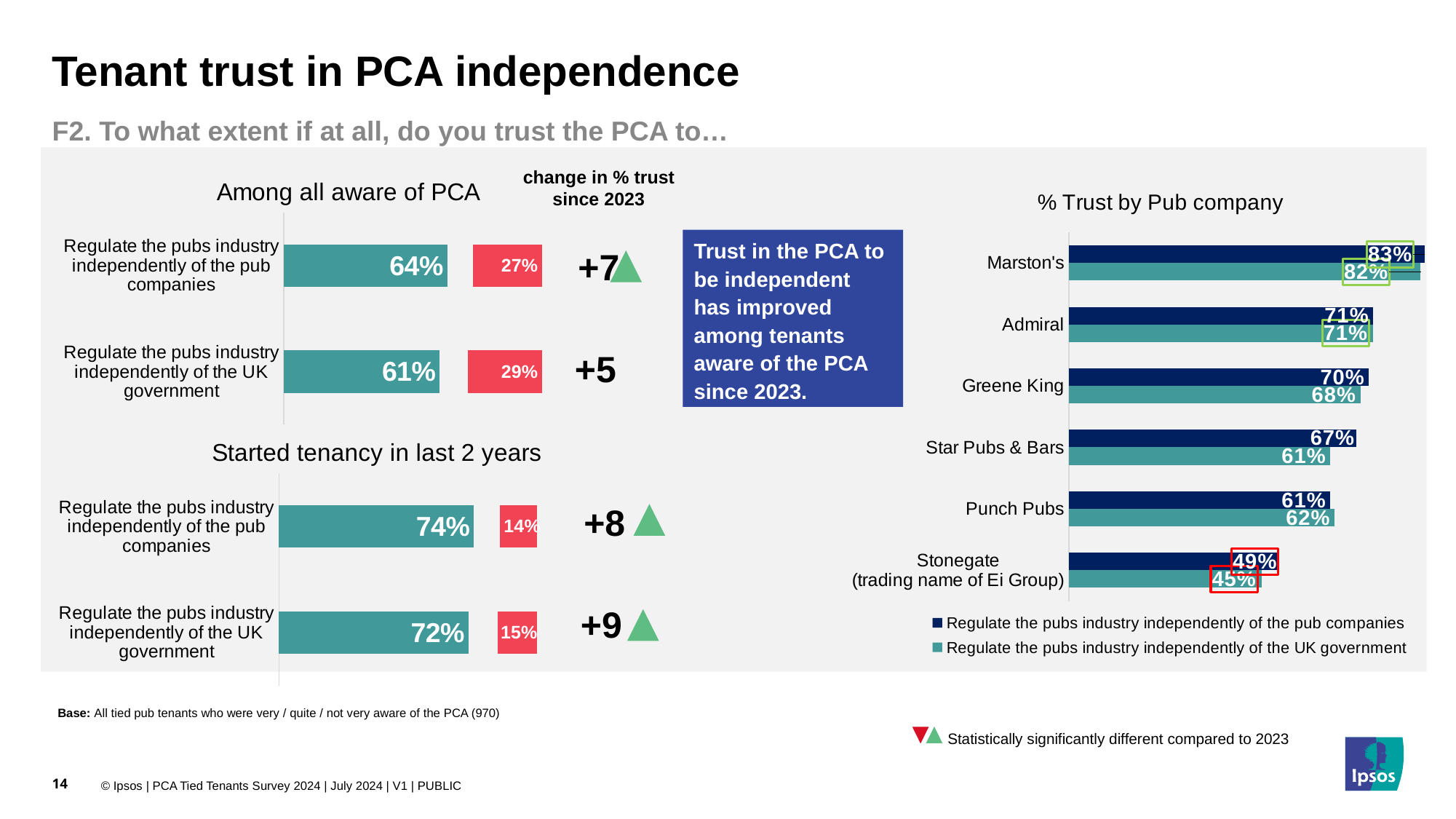
In the '% Trust by Pub company' chart, which pub company has the lowest trust for regulating independently of the UK government? Stonegate (trading name of Ei Group) In the '% Trust by Pub company' chart, which pub company has the highest trust for regulating independently of the pub companies? Marston's How many series does the legend of the '% Trust by Pub company' chart list? 2 In the 'Among all aware of PCA' chart, what percentage trust the PCA to regulate the pubs industry independently of the pub companies? 64% How many pub companies are shown in the '% Trust by Pub company' chart? 6 In the '% Trust by Pub company' chart, what is the value for Stonegate for regulating independently of the UK government? 45% In the '% Trust by Pub company' chart, what is the difference between Marston's and Stonegate for regulating independently of the pub companies? 34 percentage points In the 'Among all aware of PCA' chart, what is the change in % trust since 2023 for regulating independently of the UK government? +5 In the '% Trust by Pub company' chart, is the value for Greene King higher for regulating independently of the pub companies or of the UK government? Independently of the pub companies What type of chart is the '% Trust by Pub company' chart? Bar chart In the 'Started tenancy in last 2 years' chart, what percentage trust the PCA to regulate the pubs industry independently of the UK government? 72% In the 'Started tenancy in last 2 years' chart, what is the change in % trust since 2023 for regulating independently of the pub companies? +8